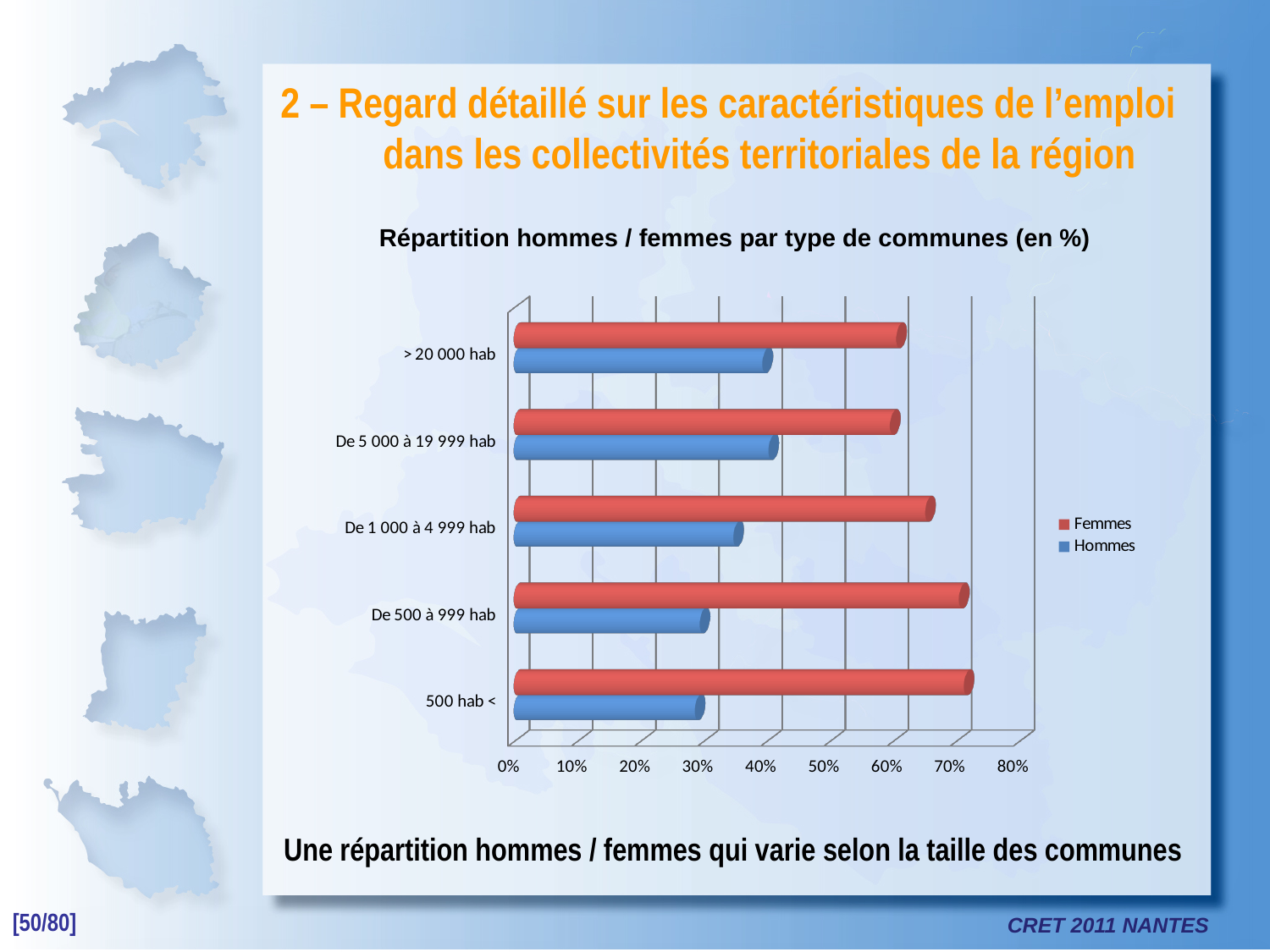
What kind of chart is shown on the slide? bar chart Is the value for Hommes in the '500 hab <' category greater or less than 40%? less How many series does the legend list? 2 Is the value for Femmes in the '> 20 000 hab' category greater or less than 50%? greater Is the value for Hommes in the 'De 500 à 999 hab' category greater or less than 40%? less What is the title of the chart? Répartition hommes / femmes par type de communes (en %) For Femmes, which is larger, the value for '500 hab <' or the value for 'De 5 000 à 19 999 hab'? 500 hab < Which series is shown in red in the legend? Femmes For Hommes, which is larger, the value for '> 20 000 hab' or the value for 'De 500 à 999 hab'? > 20 000 hab In the 'De 1 000 à 4 999 hab' category, which is larger, Femmes or Hommes? Femmes How many commune size categories are shown on the chart? 5